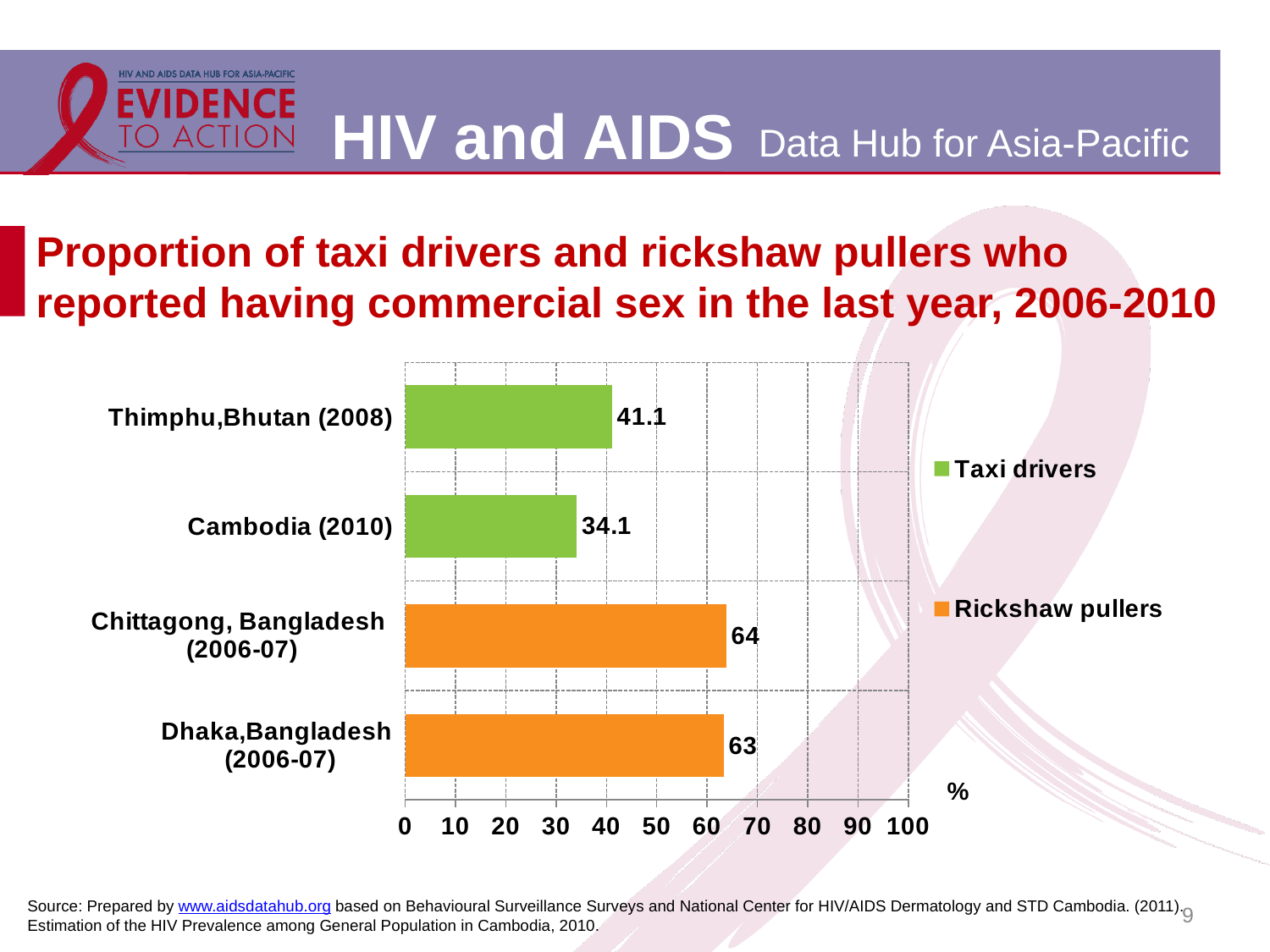
What is the difference between the values for Thimphu, Bhutan (2008) and Cambodia (2010)? 7 What kind of chart is shown on the slide? Bar chart What is the value for Chittagong, Bangladesh (2006-07)? 64 Which category has the lowest value? Cambodia (2010) How many categories are shown on the chart? 4 How many series does the legend list? 2 What is the value for Dhaka, Bangladesh (2006-07)? 63 Which is larger, the value for Thimphu, Bhutan (2008) or the value for Dhaka, Bangladesh (2006-07)? Dhaka, Bangladesh (2006-07) What is the value for Thimphu, Bhutan (2008)? 41.1 Which series is shown in orange in the legend? Rickshaw pullers Which category has the highest value? Chittagong, Bangladesh (2006-07) What is the value for Cambodia (2010)? 34.1